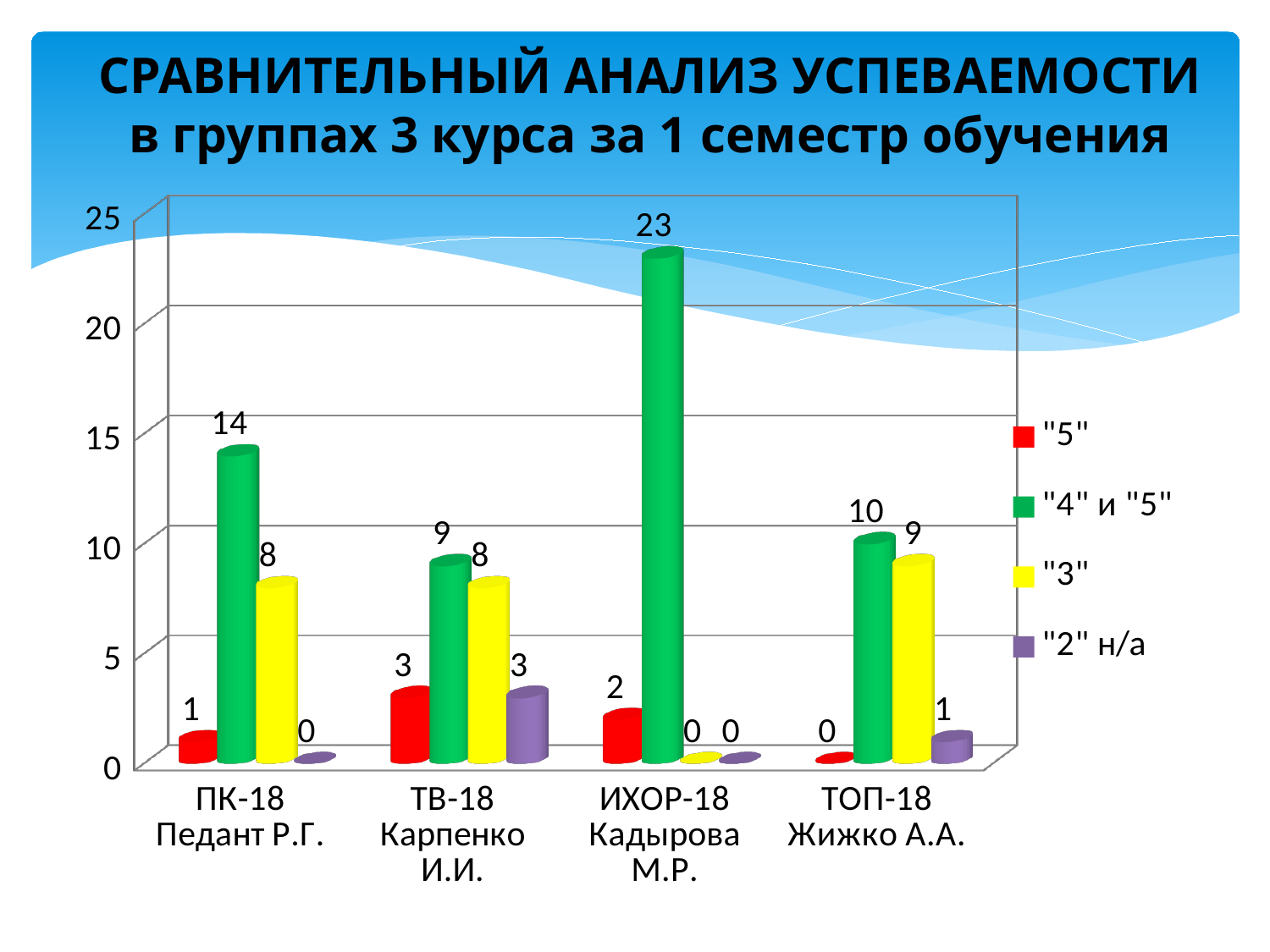
Which is larger: the "3" value for ТВ-18 Карпенко И.И. or the "3" value for ТОП-18 Жижко А.А.? ТОП-18 Жижко А.А. How many groups are shown on the x axis? 4 What is the difference between the "4" и "5" values for ИХОР-18 Кадырова М.Р. and ПК-18 Педант Р.Г.? 9 What is the value of "3" for ТОП-18 Жижко А.А.? 9 How many series does the legend list? 4 What is the value of "2" н/а for ТВ-18 Карпенко И.И.? 3 What is the value of "5" for ПК-18 Педант Р.Г.? 1 Which group has the lowest value for "5"? ТОП-18 Жижко А.А. Which group has the highest value for "4" и "5"? ИХОР-18 Кадырова М.Р. What kind of chart is shown on the slide? bar chart What is the total of all four values for ТВ-18 Карпенко И.И.? 23 What is the value of "4" и "5" for ИХОР-18 Кадырова М.Р.? 23